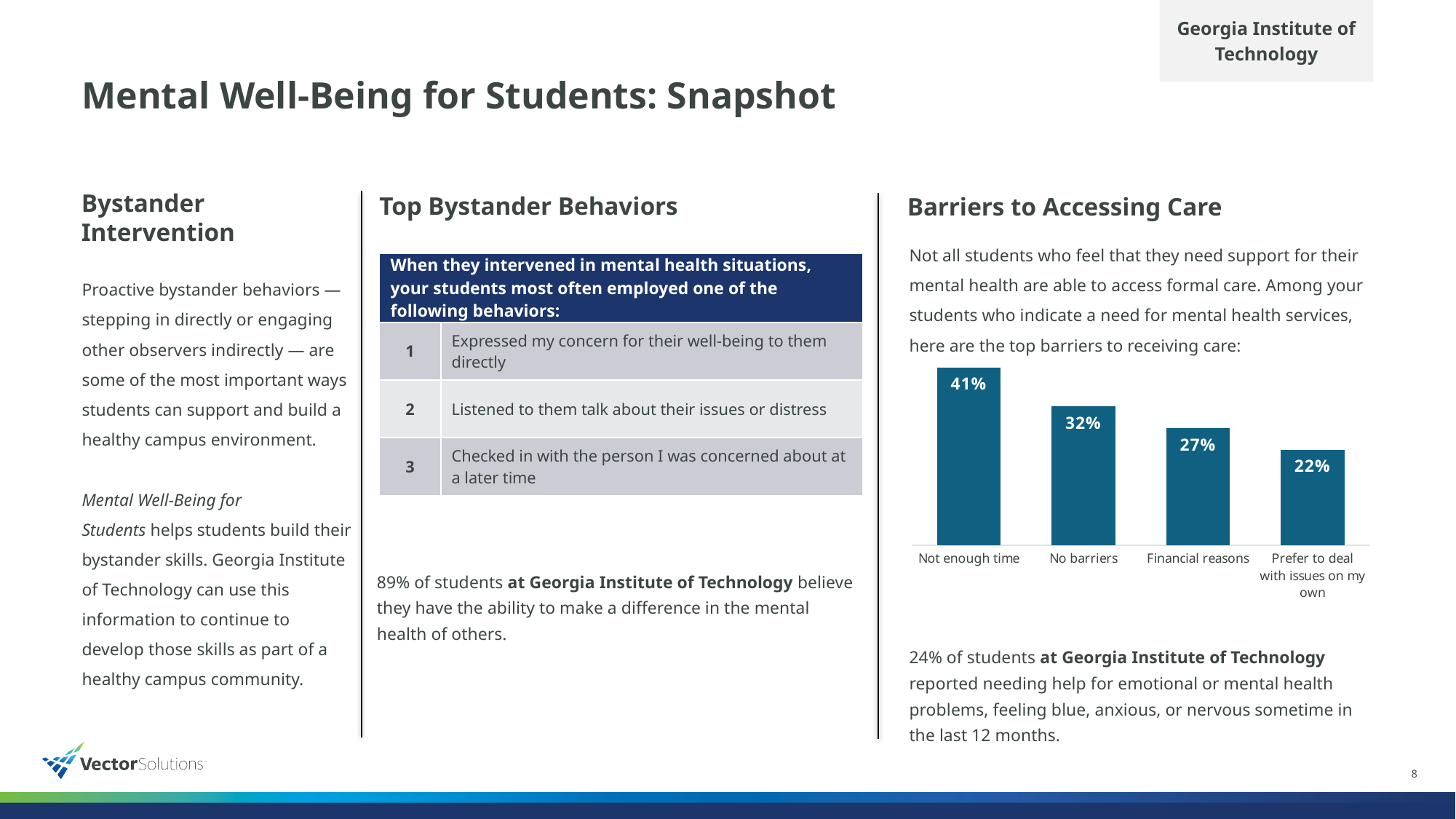
What is the difference in percentage points between "Not enough time" and "No barriers"? 9 What percentage of students cited "Not enough time" as a barrier to accessing care? 41% What type of chart is used to show the barriers to accessing care? Bar chart What is the value shown for "No barriers" in the Barriers to Accessing Care chart? 32% How many barriers are shown in the Barriers to Accessing Care chart? 4 Which is larger: the value for "No barriers" or the value for "Financial reasons"? No barriers Which barrier has the lowest percentage in the chart? Prefer to deal with issues on my own Do the values in the Barriers to Accessing Care chart rise or fall from left to right? Fall What percentage is shown for "Financial reasons"? 27% Which barrier has the highest percentage in the chart? Not enough time What is the value for "Prefer to deal with issues on my own"? 22% What is the difference between the values for "Financial reasons" and "Prefer to deal with issues on my own"? 5